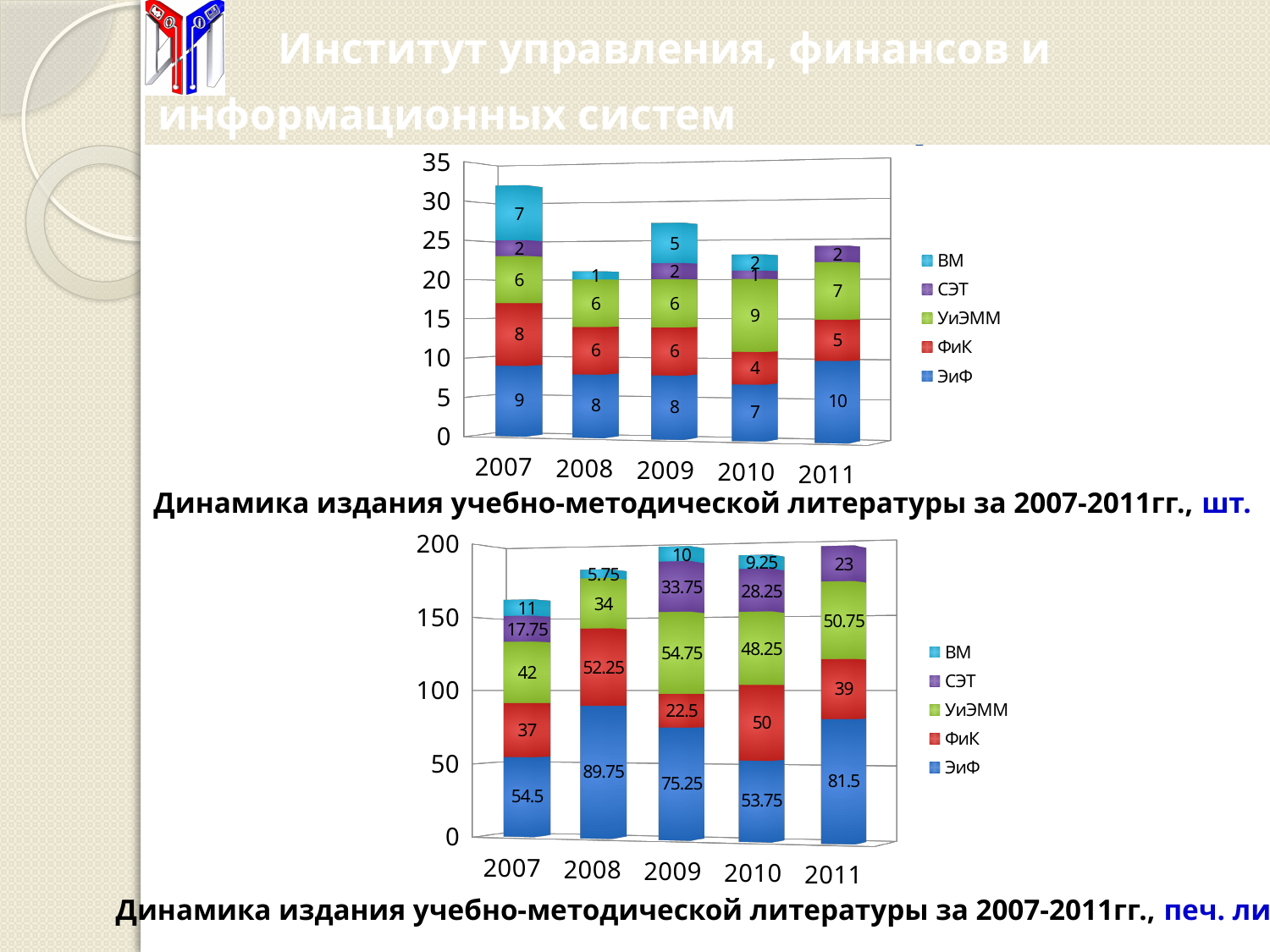
In the top chart (шт.), what is the total of the stacked bar for 2007? 32 In the top chart (шт.), what is the total of the stacked bar for 2011? 24 How many series does the legend of the bottom chart list? 5 In the bottom chart (печ. ли), what is the value for СЭТ in 2009? 33.75 In the bottom chart (печ. ли), which year has the highest value for УиЭММ? 2009 In the top chart (шт.), what is the value for ЭиФ in 2011? 10 In the bottom chart (печ. ли), what is the difference between ФиК in 2008 and ФиК in 2009? 29.75 In the top chart (шт.), which year has the lowest value for ФиК? 2010 In the top chart (шт.), what is the value for ВМ in 2007? 7 In the top chart (шт.), what is the value for УиЭММ in 2010? 9 In the bottom chart (печ. ли), what is the total of the stacked bar for 2009? 196.25 In the bottom chart (печ. ли), what is the value for ЭиФ in 2008? 89.75